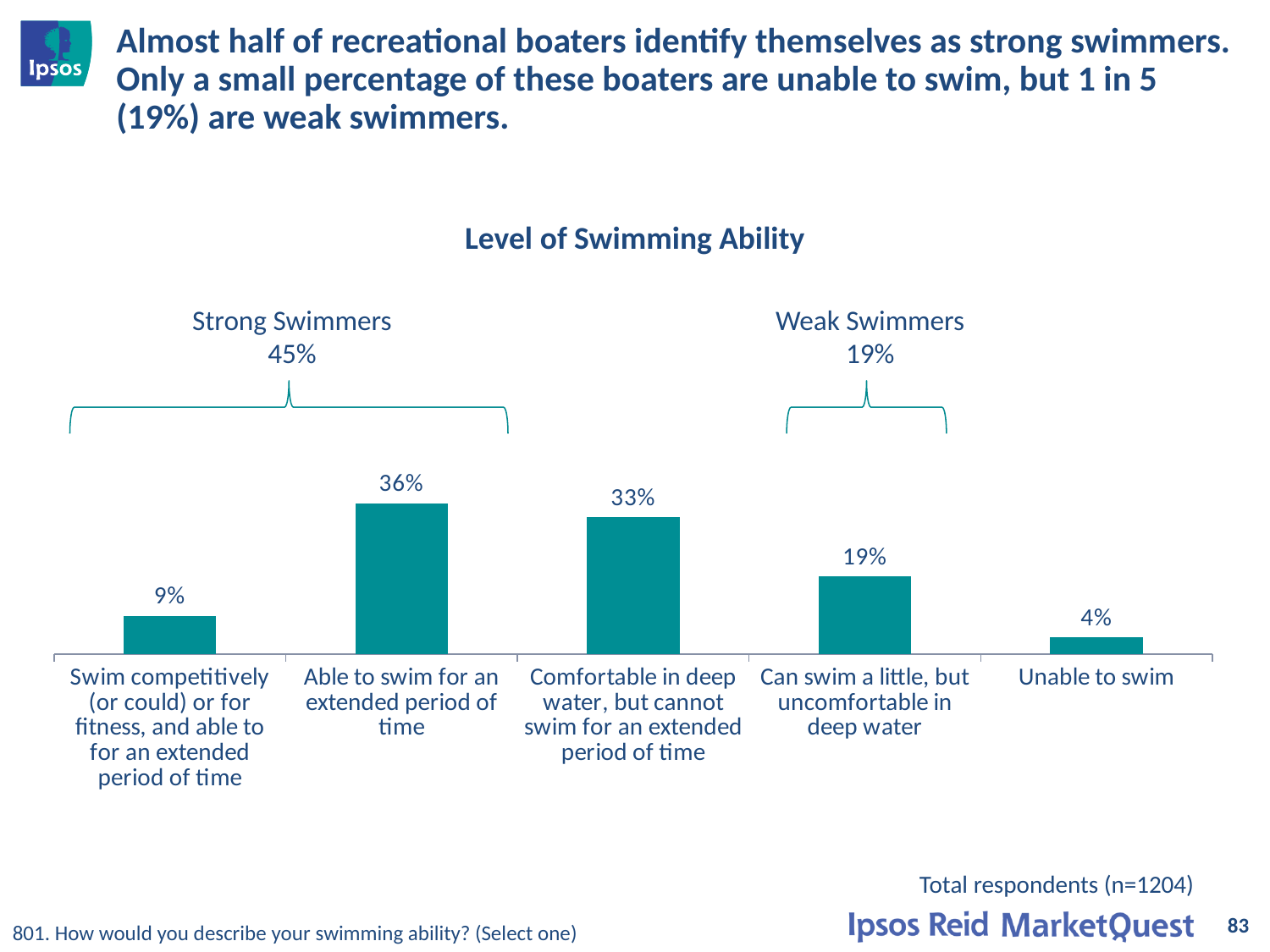
Which category has the highest value? Able to swim for an extended period of time Which is larger: the value for 'Can swim a little, but uncomfortable in deep water' or the value for 'Swim competitively (or could) or for fitness, and able to for an extended period of time'? Can swim a little, but uncomfortable in deep water What percentage is labelled as Strong Swimmers above the bracket in the chart? 45% How many categories are shown in the chart? 5 Which category has the lowest value? Unable to swim What percentage of respondents are able to swim for an extended period of time? 36% What percentage of respondents are unable to swim? 4% What is the title of the chart? Level of Swimming Ability What kind of chart is shown on the slide? Bar chart What percentage of respondents can swim a little, but are uncomfortable in deep water? 19% What percentage of respondents swim competitively (or could) or for fitness, and are able to for an extended period of time? 9% What is the difference between the value for 'Able to swim for an extended period of time' and the value for 'Comfortable in deep water, but cannot swim for an extended period of time'? 3%